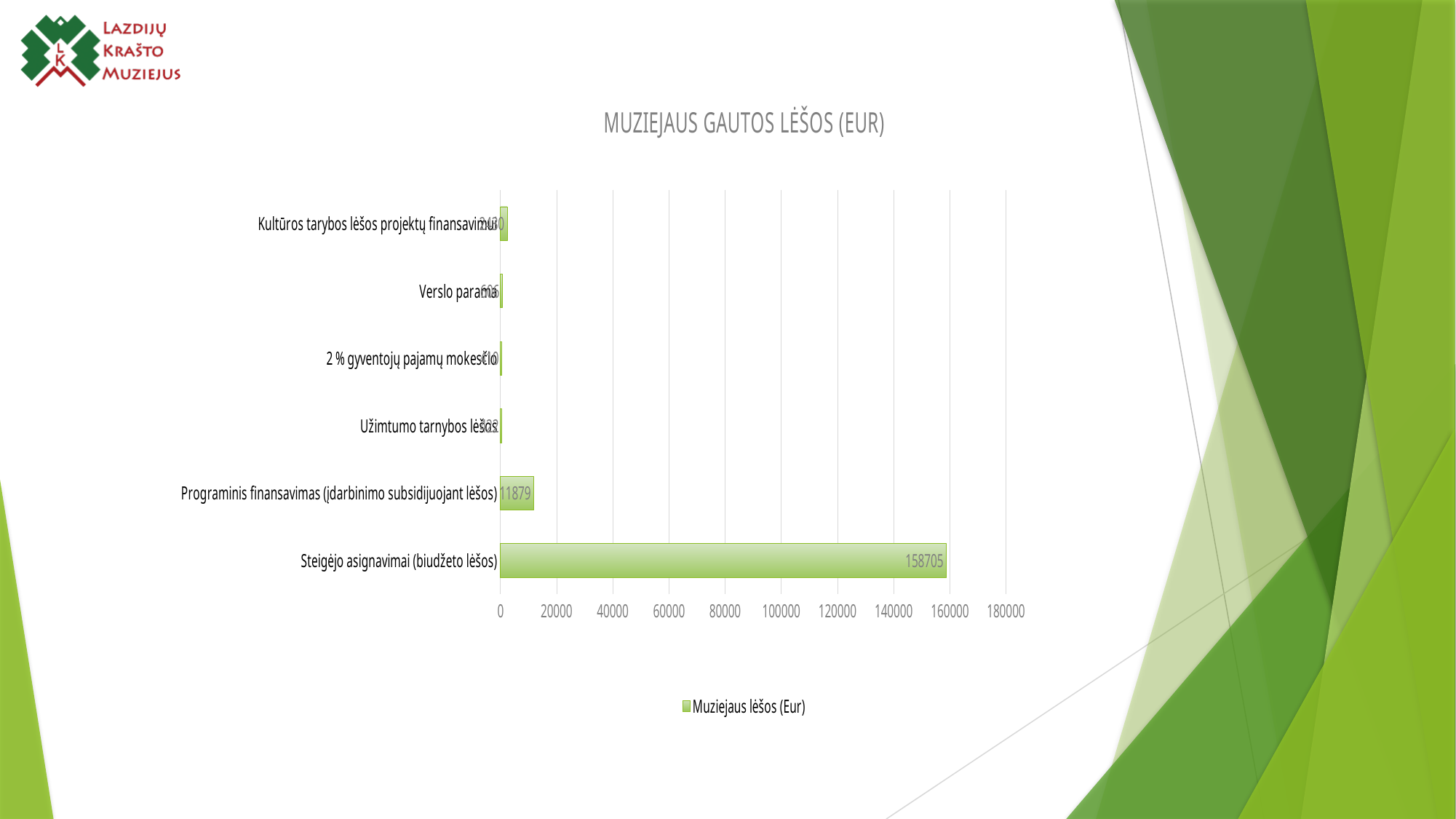
What is the title of the chart? MUZIEJAUS GAUTOS LĖŠOS (EUR) What is the value for Programinis finansavimas (įdarbinimo subsidijuojant lėšos)? 11879 How many categories are shown in the chart? 6 Is the value for Steigėjo asignavimai (biudžeto lėšos) greater or less than 140000? greater What is the value for Steigėjo asignavimai (biudžeto lėšos)? 158705 Is the value for Kultūros tarybos lėšos projektų finansavimui greater or less than 20000? less How many series does the legend list? 1 Which category has the highest value? Steigėjo asignavimai (biudžeto lėšos) Which is larger, the value for Programinis finansavimas (įdarbinimo subsidijuojant lėšos) or the value for Verslo parama? Programinis finansavimas (įdarbinimo subsidijuojant lėšos) What series name is shown in the legend? Muziejaus lėšos (Eur) What kind of chart is shown on the slide? bar chart What is the difference between the values for Steigėjo asignavimai (biudžeto lėšos) and Programinis finansavimas (įdarbinimo subsidijuojant lėšos)? 146826